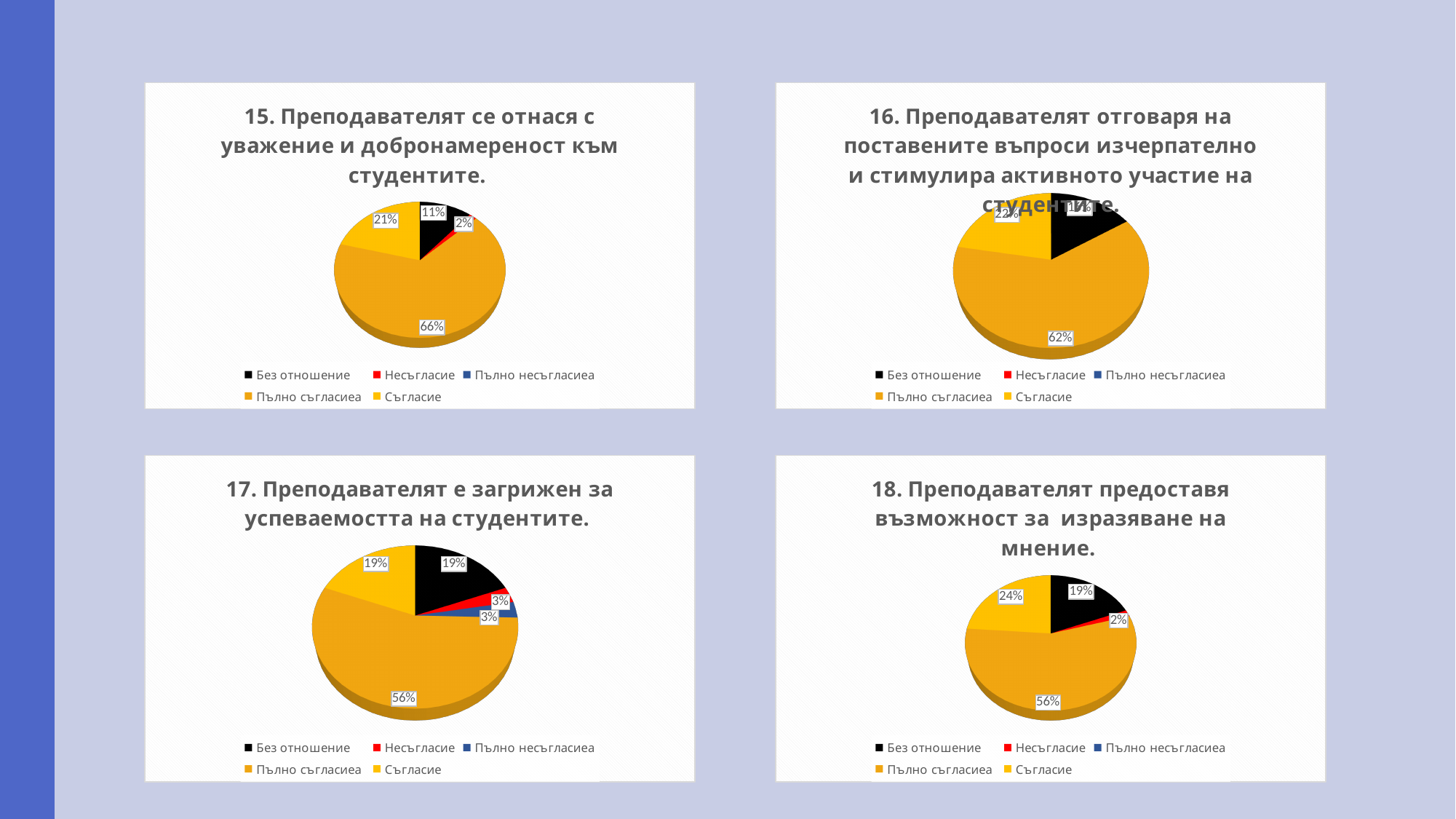
In the chart titled "18. Преподавателят предоставя възможност за изразяване на мнение.", what share does the "Съгласие" slice have? 24% In the top-right chart (question 16), what share does the "Съгласие" slice have? 22% In the chart titled "15. Преподавателят се отнася с уважение и добронамереност към студентите.", what share does the "Съгласие" slice have? 21% In the top-left chart (question 15), what is the difference between the "Пълно съгласиеа" share and the "Без отношение" share? 55% In the bottom-right chart (question 18), which is larger: the "Без отношение" share or the "Несъгласие" share? Без отношение In the bottom-left chart (question 17), what is the combined share of "Без отношение" and "Съгласие"? 38% In the bottom-left chart (question 17), which category has the largest share? Пълно съгласиеа What type of chart is used for question 15 on the slide? Pie chart In the chart titled "17. Преподавателят е загрижен за успеваемостта на студентите.", what share does the "Пълно несъгласиеа" slice have? 3% In the chart titled "16. Преподавателят отговаря на поставените въпроси изчерпателно и стимулира активното участие на студентите.", what share does the "Пълно съгласиеа" slice have? 62% How many entries does the legend of the bottom-right chart (question 18) list? 5 In the chart titled "15. Преподавателят се отнася с уважение и добронамереност към студентите.", what share does the "Пълно съгласиеа" slice have? 66%